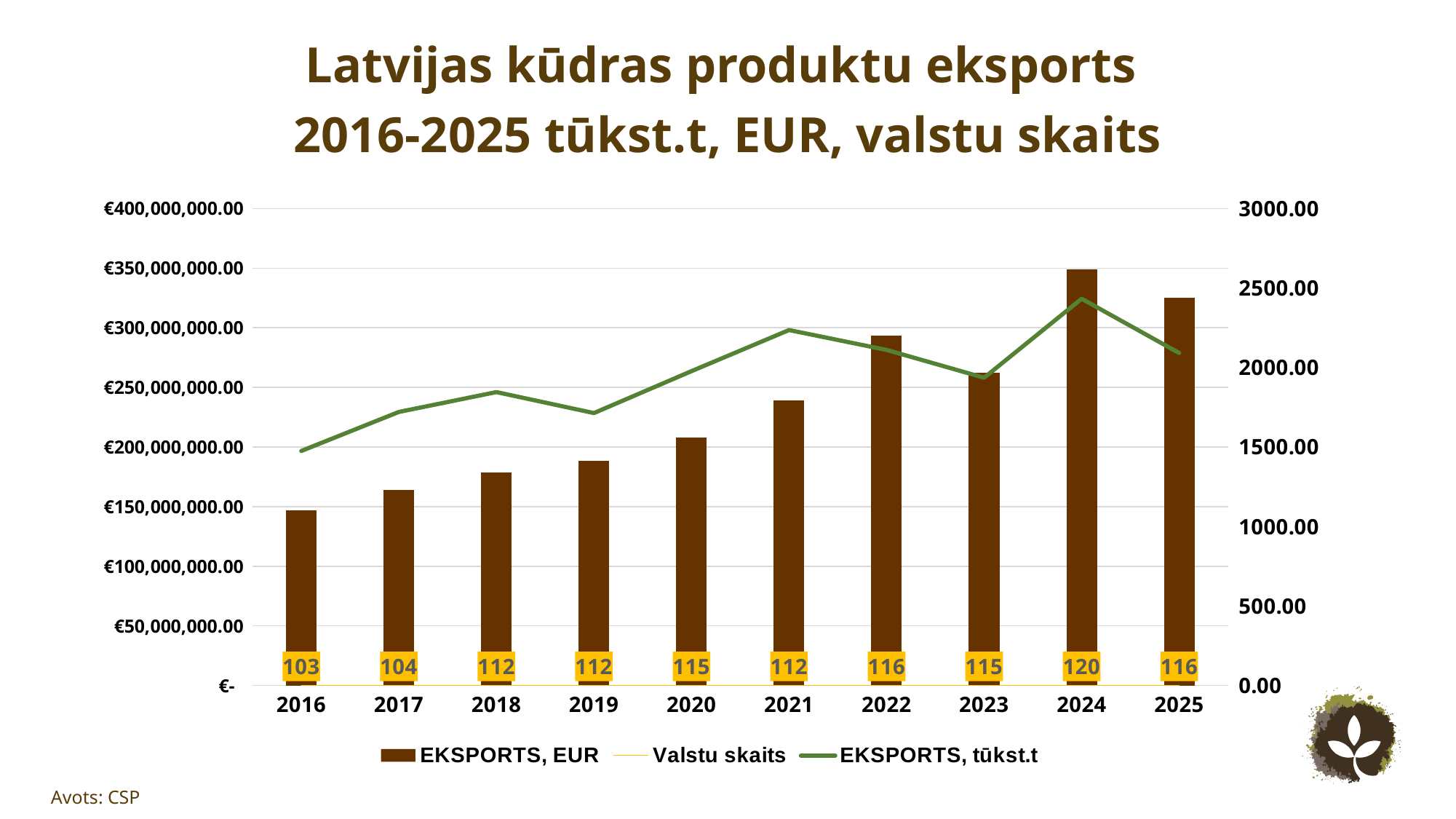
Which year has a higher Valstu skaits value, 2022 or 2023? 2022 What is the Valstu skaits value for 2024? 120 What is the difference between the Valstu skaits values for 2024 and 2016? 17 Which year has the highest Valstu skaits value? 2024 Is the EKSPORTS, tūkst.t value for 2024 greater or less than 2000.00? greater How many years are shown on the x axis? 10 Is the EKSPORTS, EUR value for 2025 greater or less than €300,000,000.00? greater What is the Valstu skaits value for 2016? 103 Which year has the tallest EKSPORTS, EUR bar? 2024 Is the EKSPORTS, EUR value for 2016 greater or less than €150,000,000.00? less Which year has the lowest Valstu skaits value? 2016 How many series does the legend list? 3